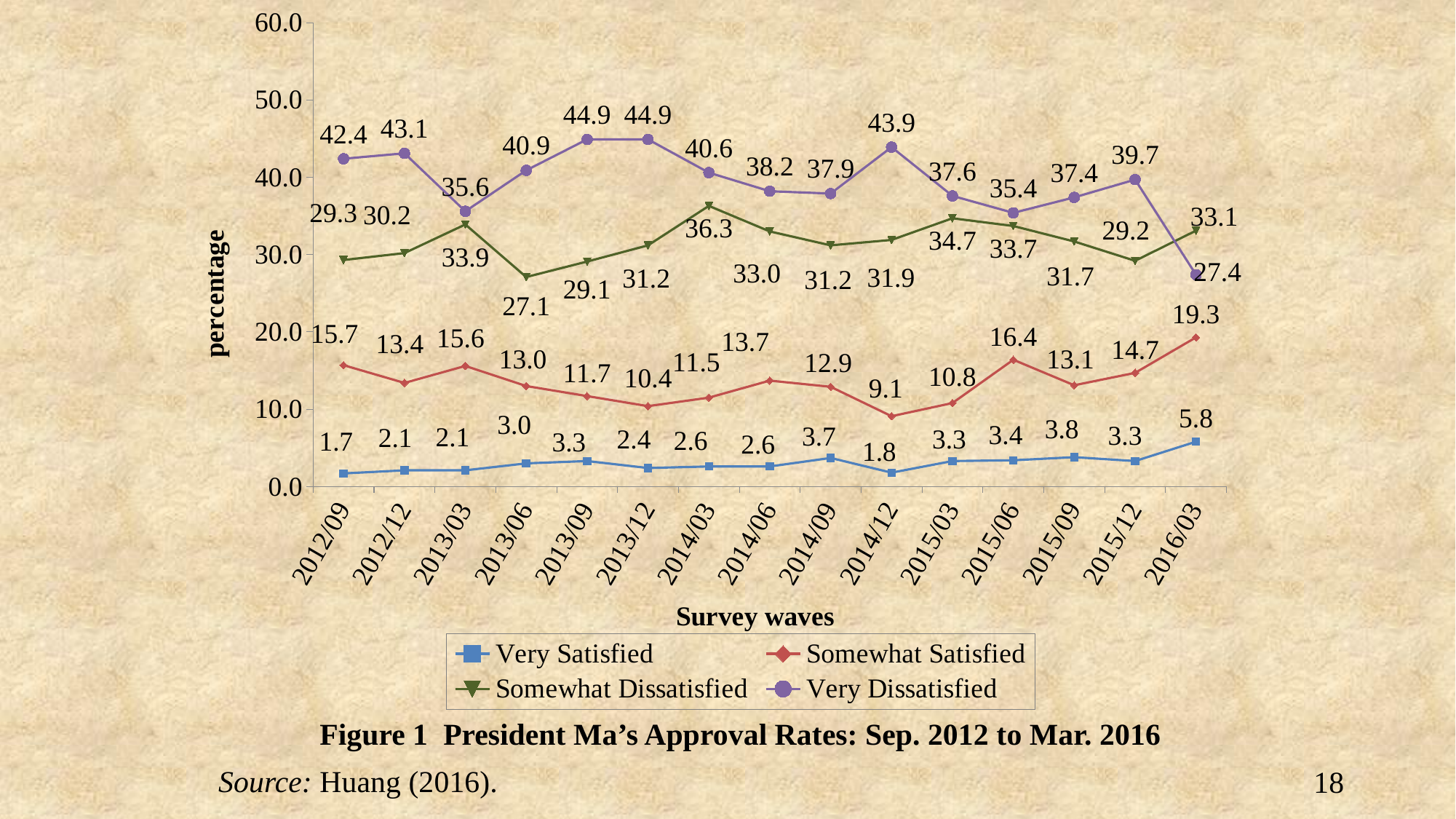
What is the Somewhat Satisfied value for 2014/12? 9.1 What kind of chart is shown on the slide? line chart In 2016/03, which is larger: Somewhat Dissatisfied or Very Dissatisfied? Somewhat Dissatisfied How many survey waves are plotted along the x axis? 15 Does the Very Dissatisfied series rise or fall from 2015/12 to 2016/03? fall How many series does the legend list? 4 In which survey wave is the Very Satisfied series highest? 2016/03 What is the difference between the Very Dissatisfied and Somewhat Dissatisfied values in 2012/09? 13.1 In which survey wave is the Very Dissatisfied series lowest? 2016/03 What is the title of the y axis? percentage What is the Somewhat Dissatisfied value for 2014/03? 36.3 What is the Very Dissatisfied value for 2016/03? 27.4